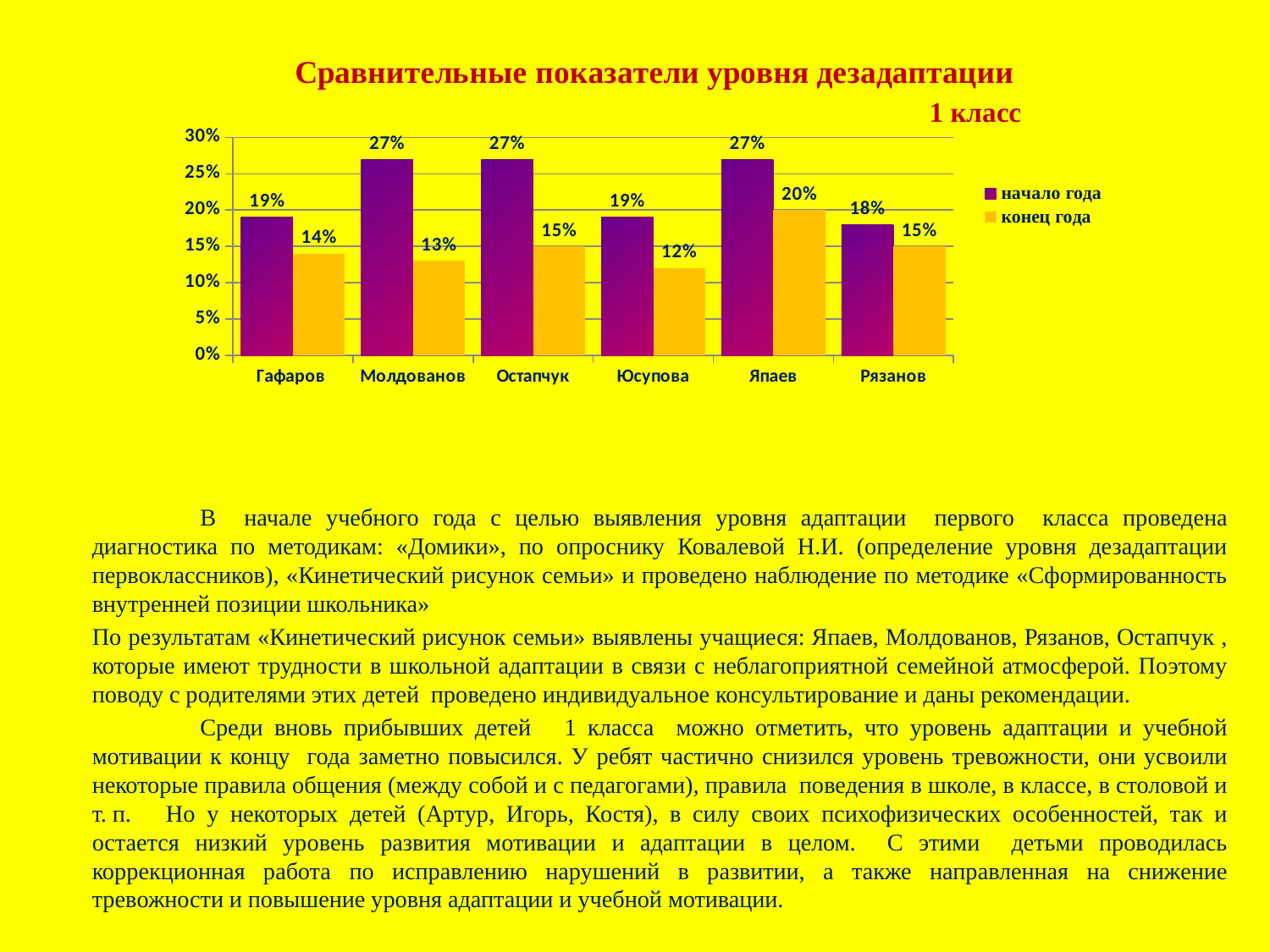
Which category has the highest value in the 'конец года' series? Япаев What is the title of the chart? Сравнительные показатели уровня дезадаптации Which category has the lowest value in the 'конец года' series? Юсупова What type of chart is shown on the slide? bar chart What is the difference between the 'начало года' and 'конец года' values for Молдованов? 14% Which is larger for Остапчук: the 'начало года' value or the 'конец года' value? начало года What is the value for Гафаров in the 'начало года' series? 19% How many series does the legend list? 2 Which category has the lowest value in the 'начало года' series? Рязанов How many categories (students) are shown on the x axis? 6 What is the value for Юсупова in the 'конец года' series? 12% What is the value for Япаев in the 'конец года' series? 20%